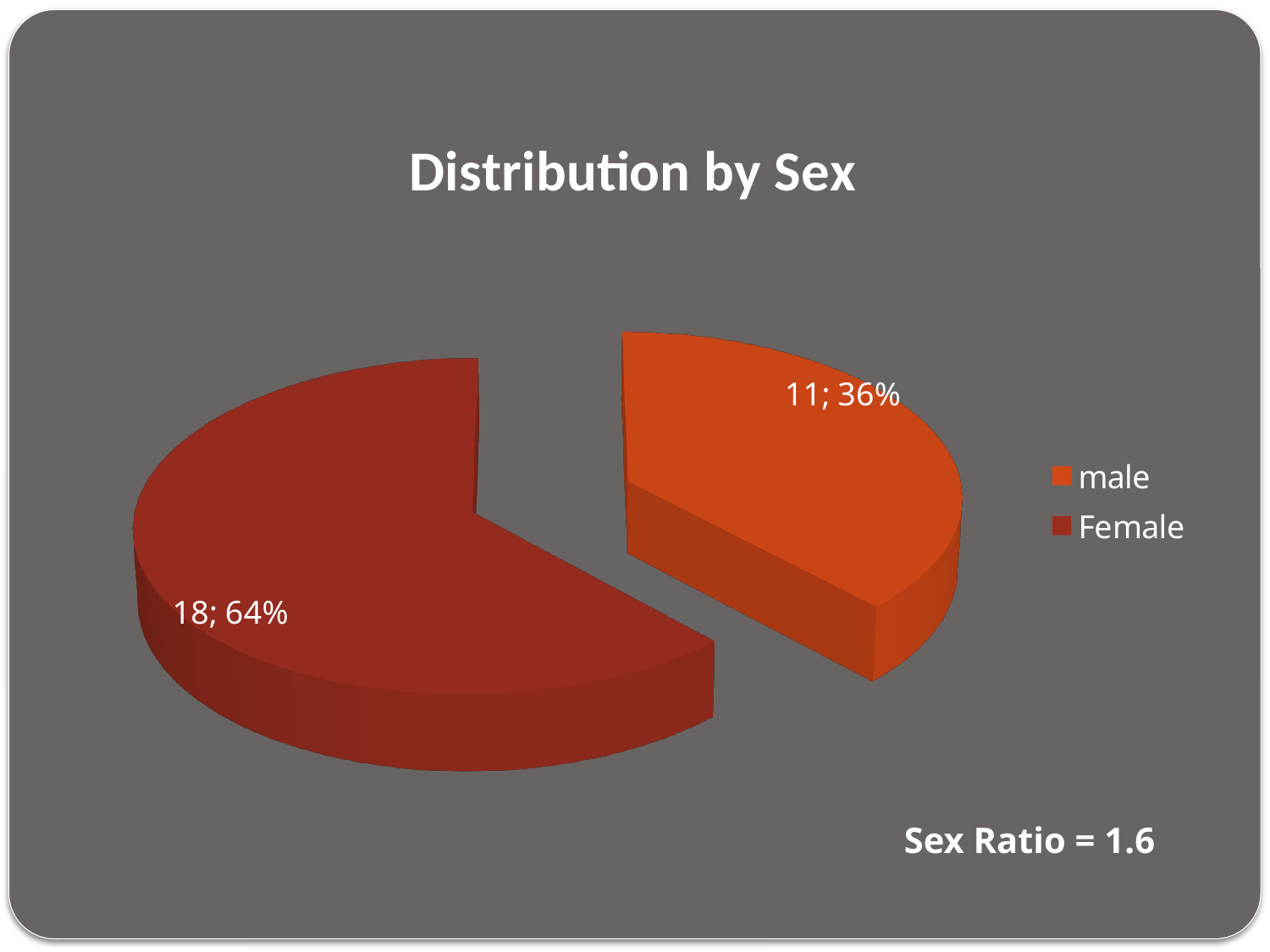
What share of the pie does the male slice represent? 36% What is the title of the chart? Distribution by Sex What kind of chart is shown on the slide? pie chart What share of the pie does the Female slice represent? 64% Which category has the largest slice? Female How many slices does the pie chart have? 2 What is the count for Female? 18 What is the total count across both slices? 29 How many entries does the legend list? 2 What is the count for male? 11 What is the difference between the Female count and the male count? 7 Which category has the smallest slice? male